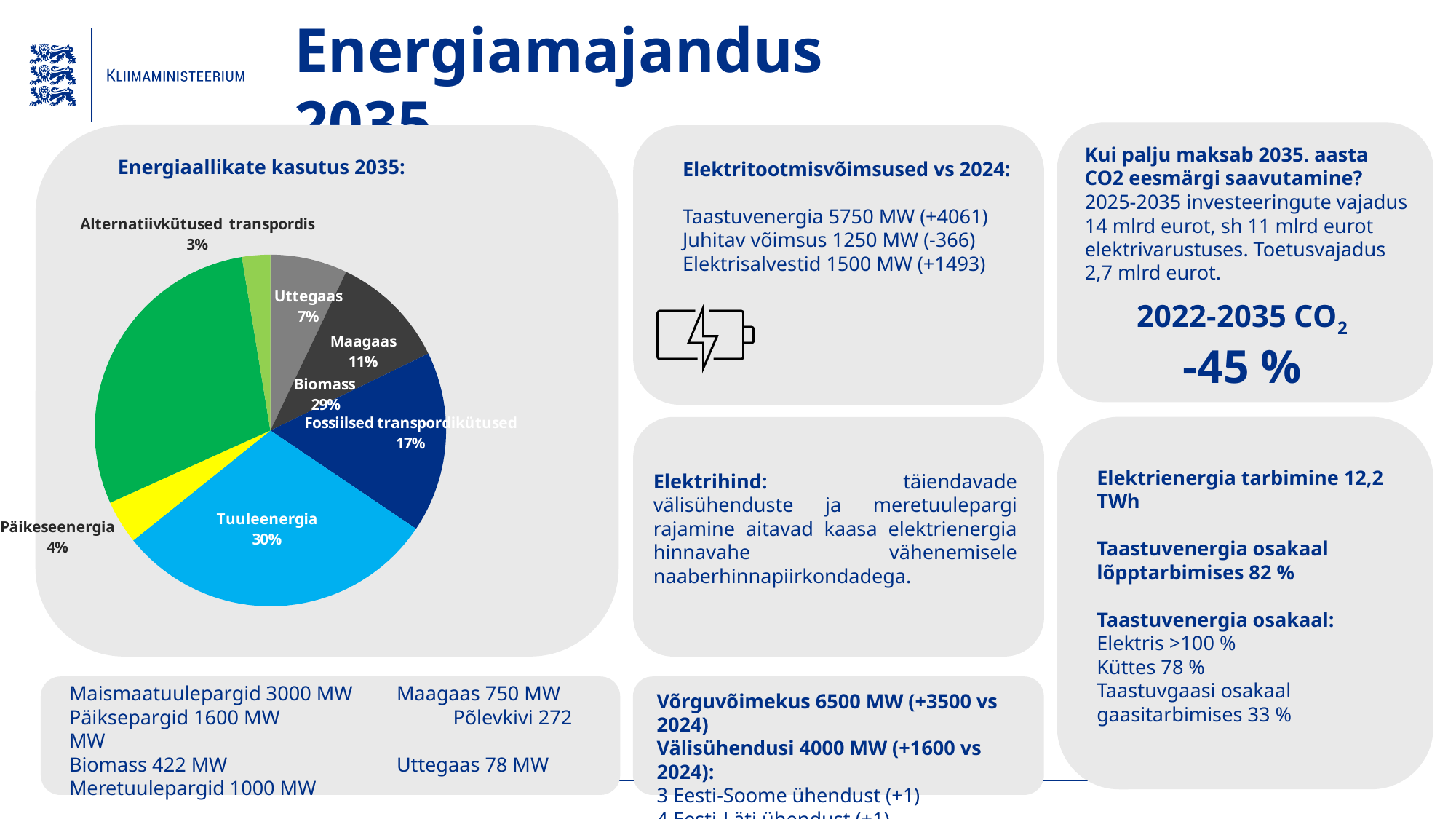
What is the difference in percentage points between Maagaas and Uttegaas? 4% How many categories are shown in the pie chart? 7 What percentage is shown for Maagaas in the pie chart? 11% What is the value shown for Biomass in the pie chart? 29% What share of the pie chart does Tuuleenergia represent? 30% What is the value for Päikeseenergia in the pie chart? 4% What is the title of the pie chart? Energiaallikate kasutus 2035: Which is larger in the pie chart, Biomass or Maagaas? Biomass Which category has the largest slice in the pie chart? Tuuleenergia What type of chart is shown on the slide? Pie chart Which category has the smallest slice in the pie chart? Alternatiivkütused transpordis What percentage is shown for Fossiilsed transpordikütused? 17%